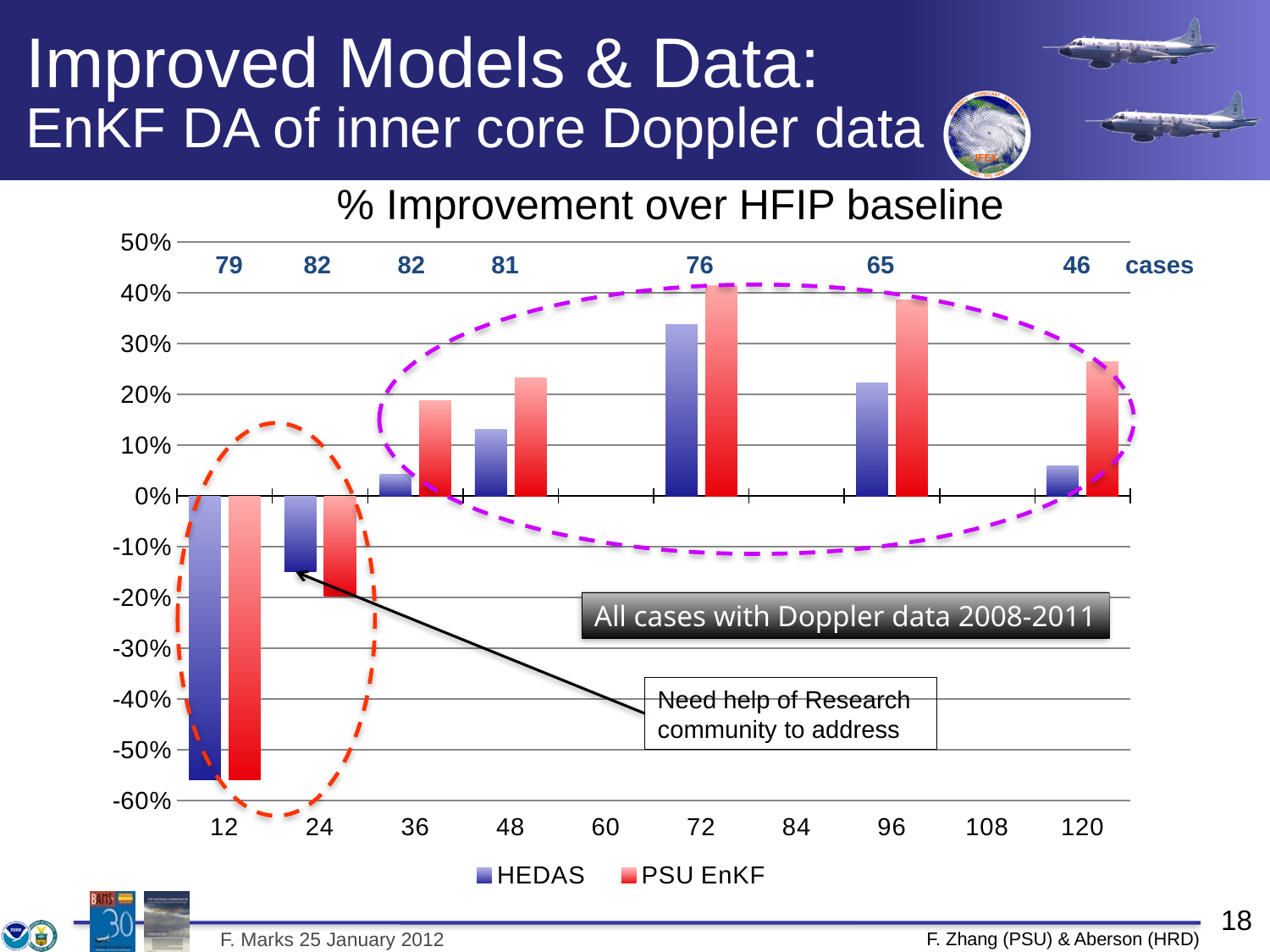
Is the PSU EnKF value at x = 96 greater or less than 30%? greater Is the HEDAS value at x = 72 greater or less than 30%? greater What are the two series named in the legend? HEDAS and PSU EnKF At which x-axis value does the HEDAS series reach its lowest value? 12 Is the HEDAS value at x = 12 greater or less than -50%? less Does the HEDAS series rise or fall from x = 12 to x = 72? rise What is the title of the chart? % Improvement over HFIP baseline What kind of chart is shown on the slide? bar chart At x = 72, which series has the larger value, HEDAS or PSU EnKF? PSU EnKF How many series does the legend list? 2 At which x-axis value does the PSU EnKF series reach its highest value? 72